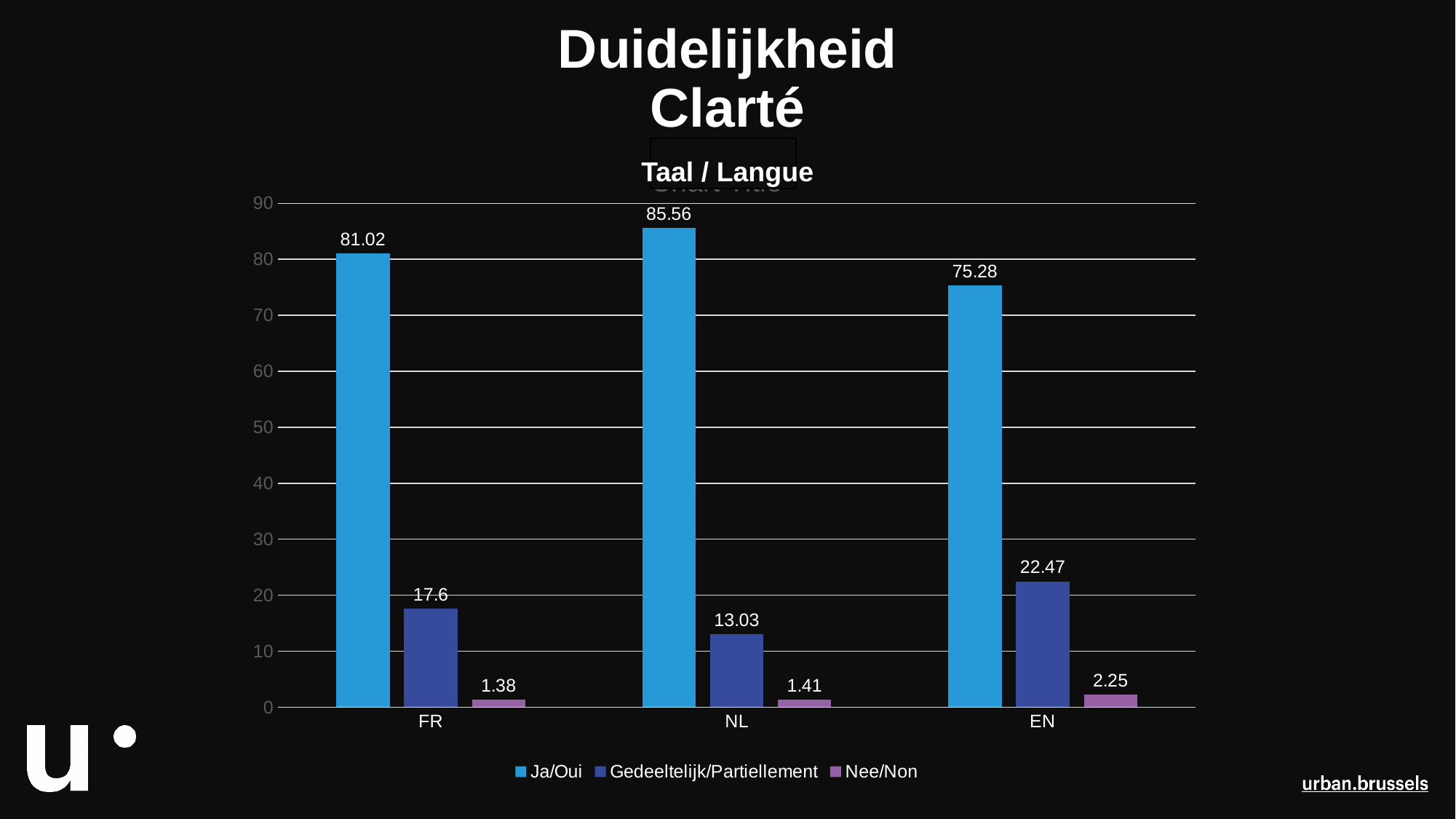
Which is larger: the Nee/Non value for EN or the Nee/Non value for NL? EN Which language has the highest Ja/Oui value? NL What is the Ja/Oui value for NL? 85.56 How many series does the legend list? 3 Which language has the lowest Gedeeltelijk/Partiellement value? NL How many language categories are shown on the x axis? 3 Is the Ja/Oui value for FR greater or less than 80? greater What is the title shown above the chart? Taal / Langue What kind of chart is shown on the slide? bar chart What is the Gedeeltelijk/Partiellement value for EN? 22.47 What is the Nee/Non value for FR? 1.38 What is the difference between the Ja/Oui values for NL and EN? 10.28